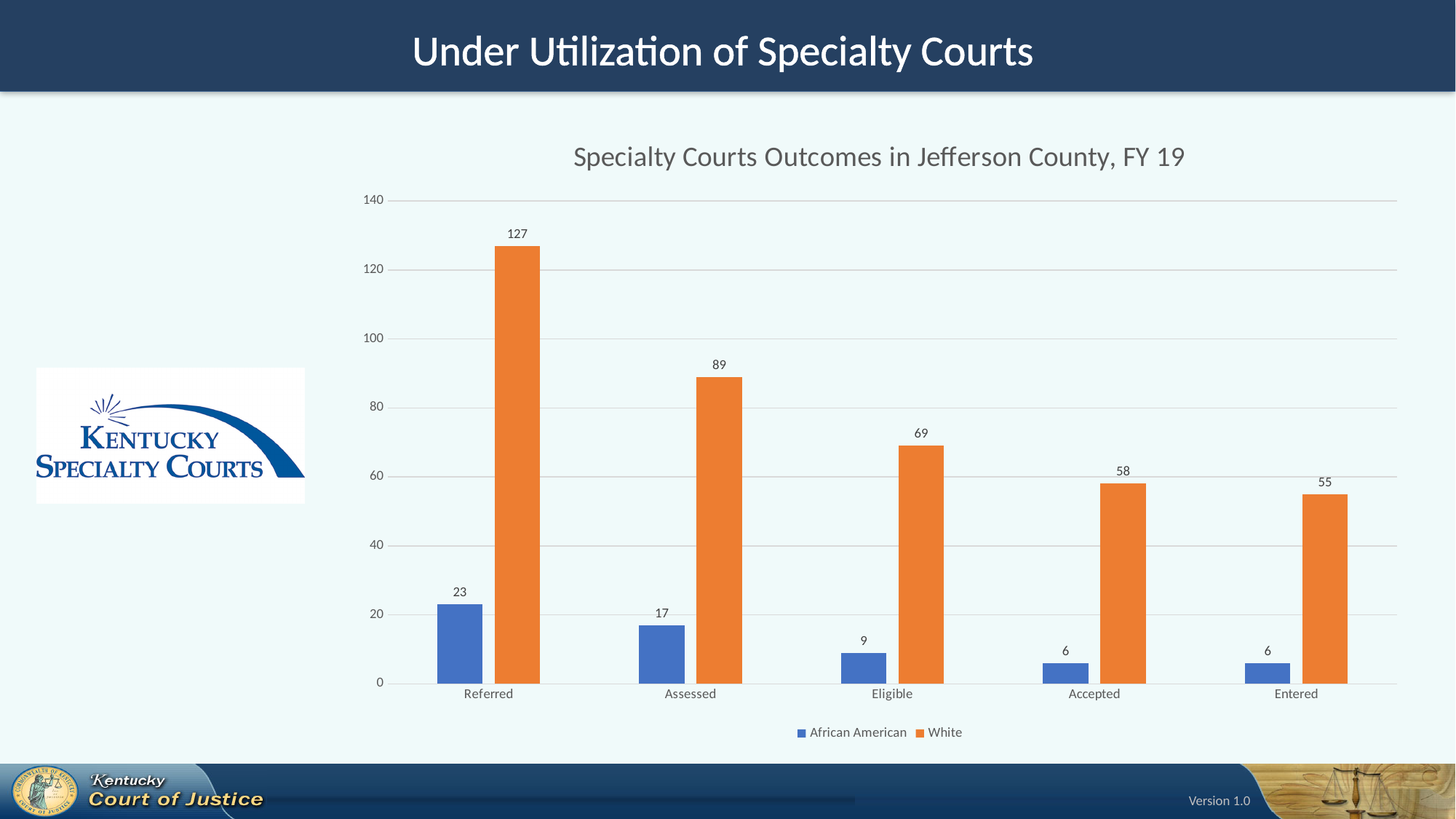
How many categories are shown on the x axis? 5 Which category has the highest value for African American? Referred Which category has the lowest value for White? Entered What is the value for African American in the Assessed category? 17 How many series does the legend list? 2 What is the difference between the White and African American values in the Eligible category? 60 What is the title of the chart? Specialty Courts Outcomes in Jefferson County, FY 19 Which is larger: the White value for Accepted or the White value for Entered? Accepted What is the value for White in the Referred category? 127 What kind of chart is shown on the slide? Bar chart What is the value for White in the Entered category? 55 Is the White value for Assessed greater or less than 80? greater